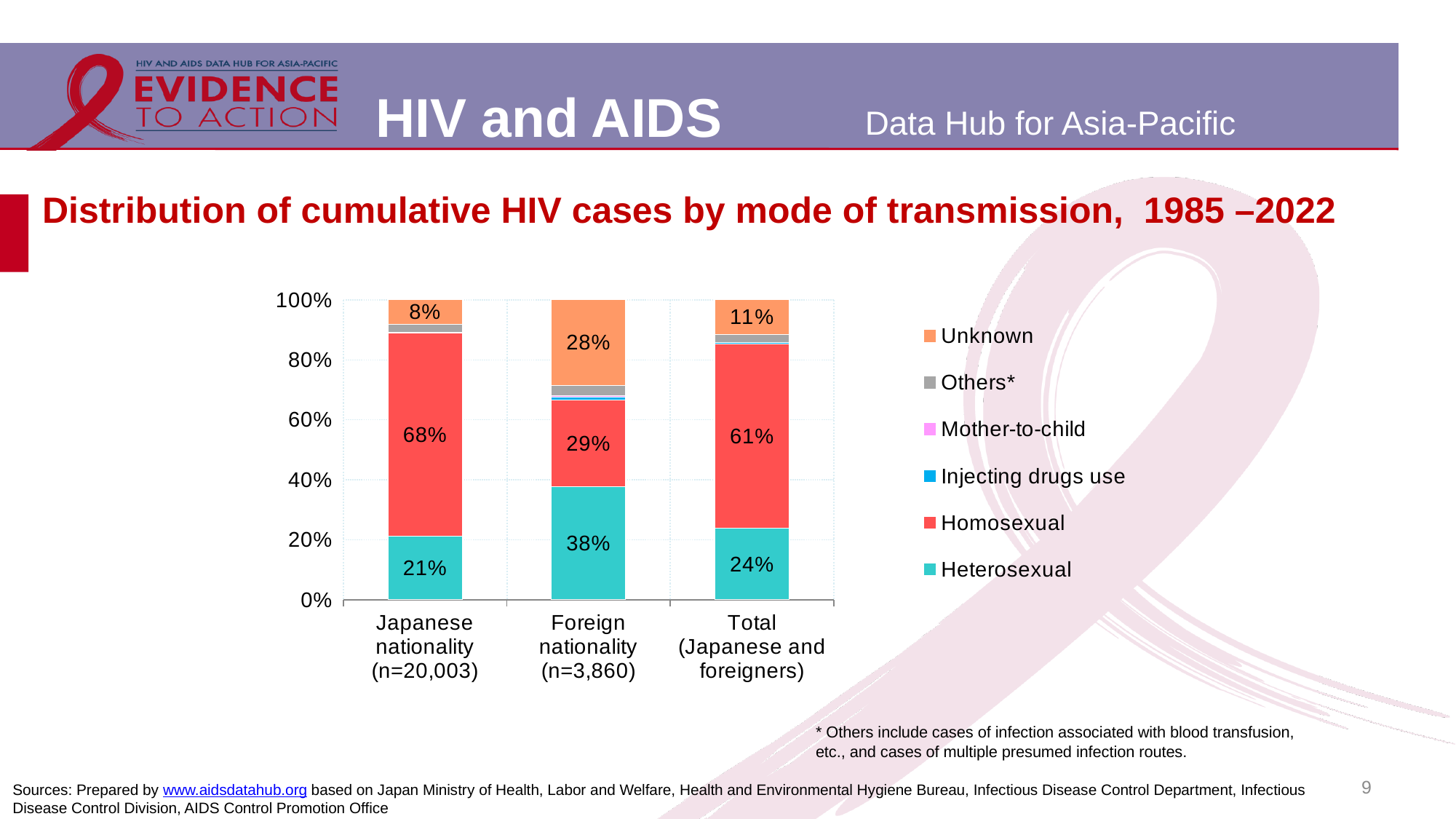
What kind of chart is shown on the slide? Stacked bar chart Is the heterosexual share larger for Japanese nationality or for foreign nationality? Foreign nationality What is the Unknown share for the Foreign nationality bar? 28% What is the sample size (n) shown for the Japanese nationality category? n=20,003 How many series does the legend list? 6 Which nationality group has the lowest Unknown share? Japanese nationality What is the difference between the homosexual share for Japanese nationality and for foreign nationality? 39 percentage points What is the Unknown share for the Total (Japanese and foreigners) bar? 11% Which nationality group has the highest homosexual transmission share? Japanese nationality What share of cumulative HIV cases among Japanese nationality is attributed to homosexual transmission? 68% How many nationality categories are shown on the x axis? 3 What share of cumulative HIV cases among foreign nationality is attributed to heterosexual transmission? 38%